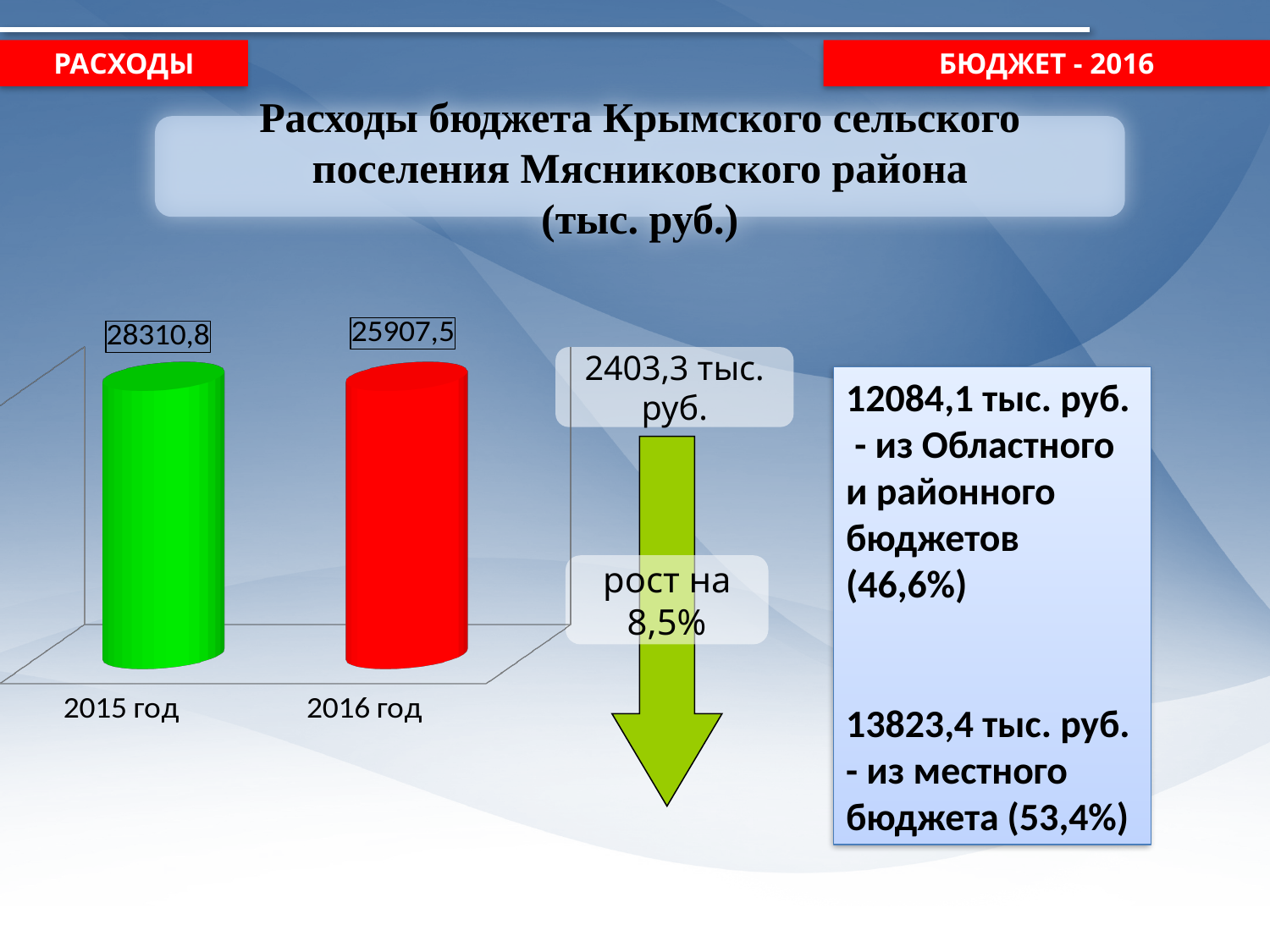
What kind of chart is shown on the slide? bar chart Which year has the lowest value? 2016 год What colour is the bar for 2015 год? green How many categories are shown in the chart? 2 What colour is the bar for 2016 год? red What is the difference between the values for 2015 год and 2016 год? 2403,3 Which is larger, the value for 2015 год or for 2016 год? 2015 год What is the value for 2015 год? 28310,8 What is the value for 2016 год? 25907,5 Which year has the highest value? 2015 год Do the values rise or fall from 2015 год to 2016 год? fall